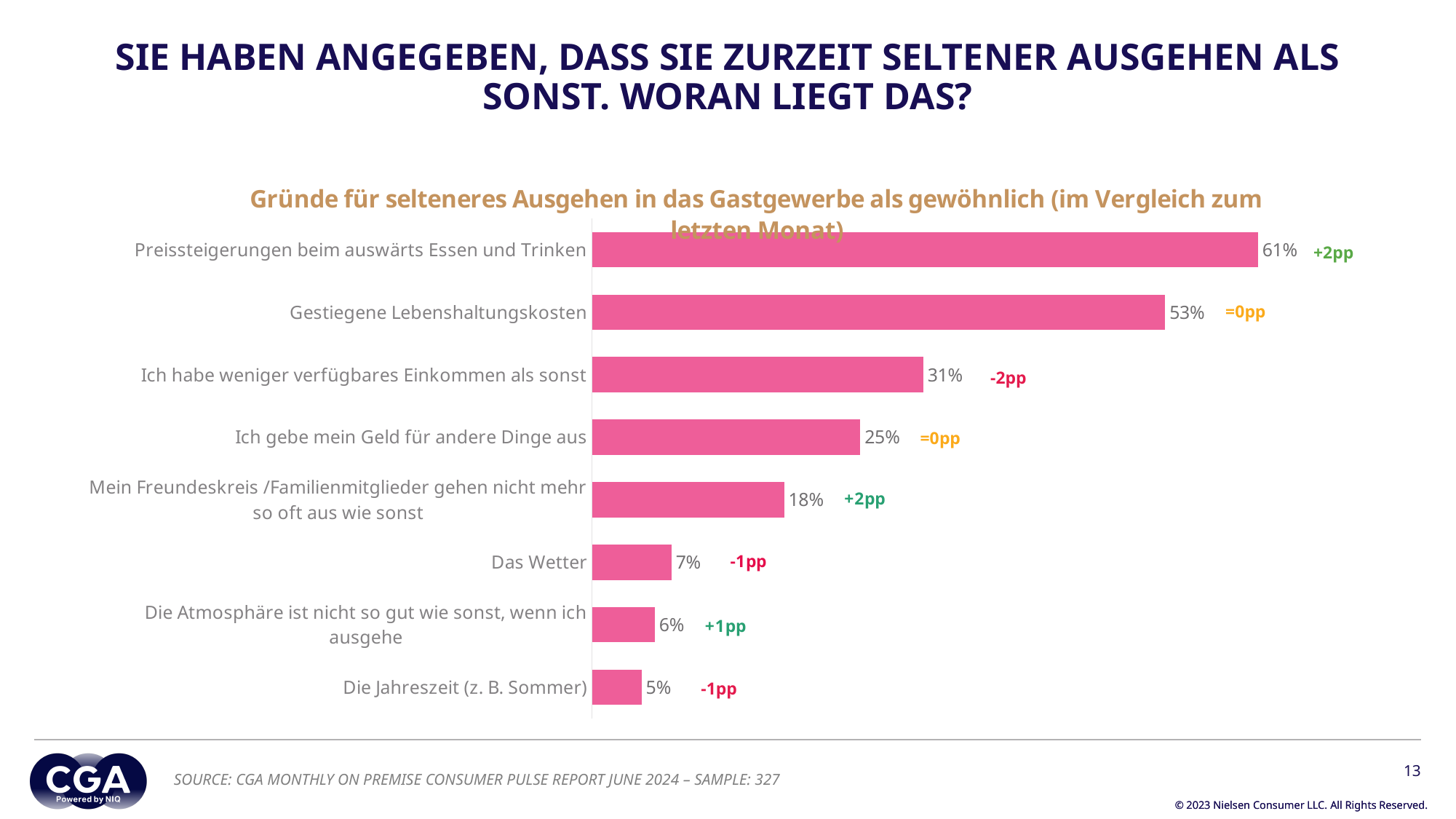
What percentage is shown for "Preissteigerungen beim auswärts Essen und Trinken"? 61% What is the difference in percentage points between "Preissteigerungen beim auswärts Essen und Trinken" and "Gestiegene Lebenshaltungskosten"? 8 percentage points Which category has the highest percentage? Preissteigerungen beim auswärts Essen und Trinken Which is larger: the value for "Ich gebe mein Geld für andere Dinge aus" or the value for "Mein Freundeskreis /Familienmitglieder gehen nicht mehr so oft aus wie sonst"? Ich gebe mein Geld für andere Dinge aus How many categories (reasons) are shown in the chart? 8 What is the difference between the values for "Das Wetter" and "Die Jahreszeit (z. B. Sommer)"? 2 percentage points What colour are the bars in the chart? Pink What percentage is shown for "Gestiegene Lebenshaltungskosten"? 53% Which category has the lowest percentage? Die Jahreszeit (z. B. Sommer) What percentage is shown for "Das Wetter"? 7% What is the change in percentage points shown next to "Ich habe weniger verfügbares Einkommen als sonst"? -2pp What kind of chart is shown on the slide? Bar chart